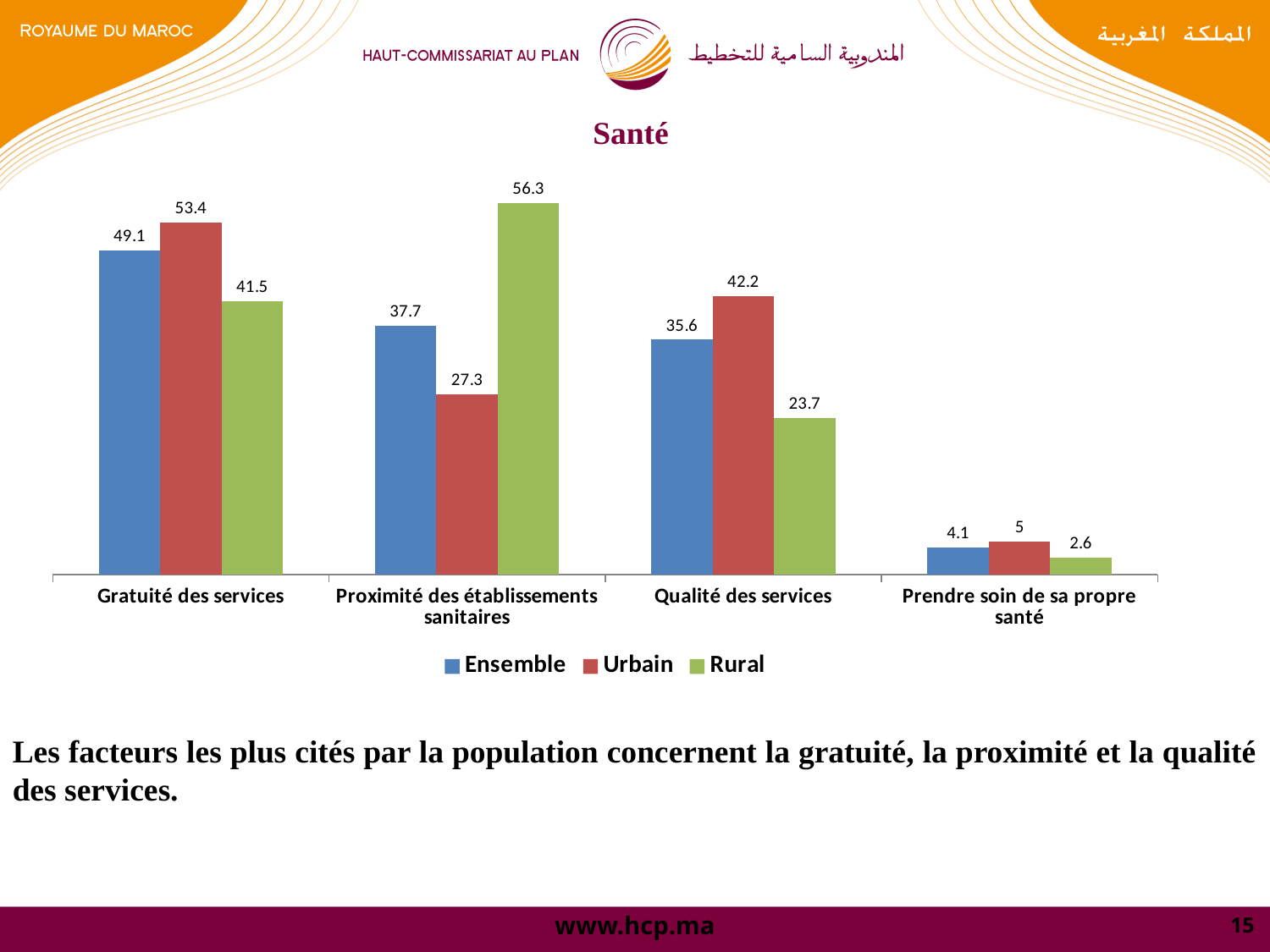
What is the Urbain value for Gratuité des services? 53.4 What is the difference between the Rural and Urbain values for Proximité des établissements sanitaires? 29 What is the title of the chart? Santé What is the Rural value for Prendre soin de sa propre santé? 2.6 What is the Ensemble value for Qualité des services? 35.6 What kind of chart is shown on the slide? Bar chart What is the Rural value for Proximité des établissements sanitaires? 56.3 Which category has the lowest Urbain value? Prendre soin de sa propre santé Which is larger for Qualité des services, the Urbain value or the Rural value? Urbain Which category has the highest Ensemble value? Gratuité des services How many series does the legend list? 3 How many categories are shown on the x axis? 4